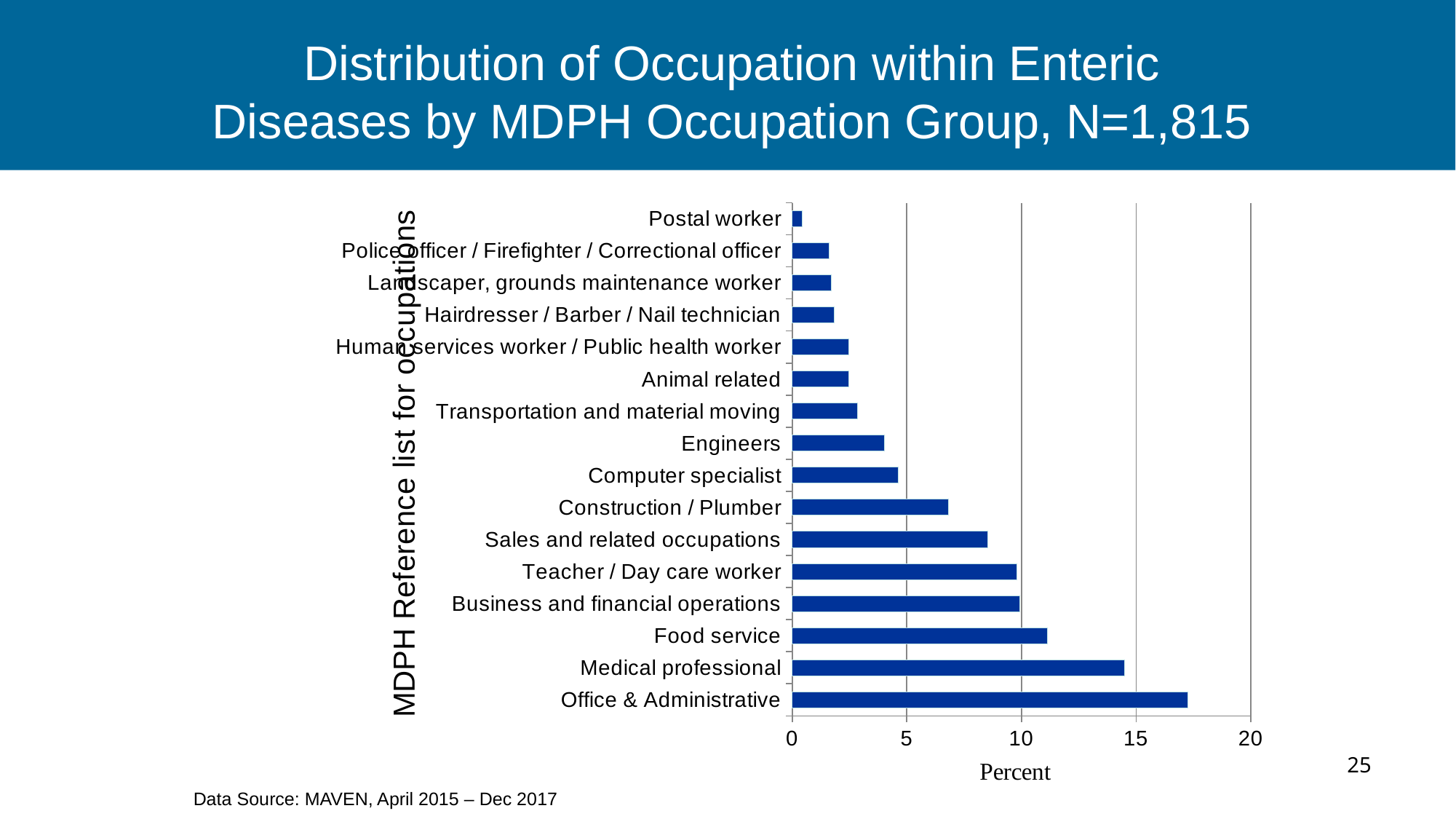
Is the value for Food service greater or less than 10? greater Is the value for Medical professional greater or less than 15? less Is the value for Office & Administrative greater or less than 15? greater What is the label on the horizontal axis of the chart? Percent Which occupation group has the highest percentage? Office & Administrative How many occupation groups are plotted in the chart? 16 What kind of chart is shown on the slide? bar chart Which is larger, the value for Medical professional or the value for Food service? Medical professional Which occupation group has the lowest percentage? Postal worker Which is larger, the value for Computer specialist or the value for Sales and related occupations? Sales and related occupations